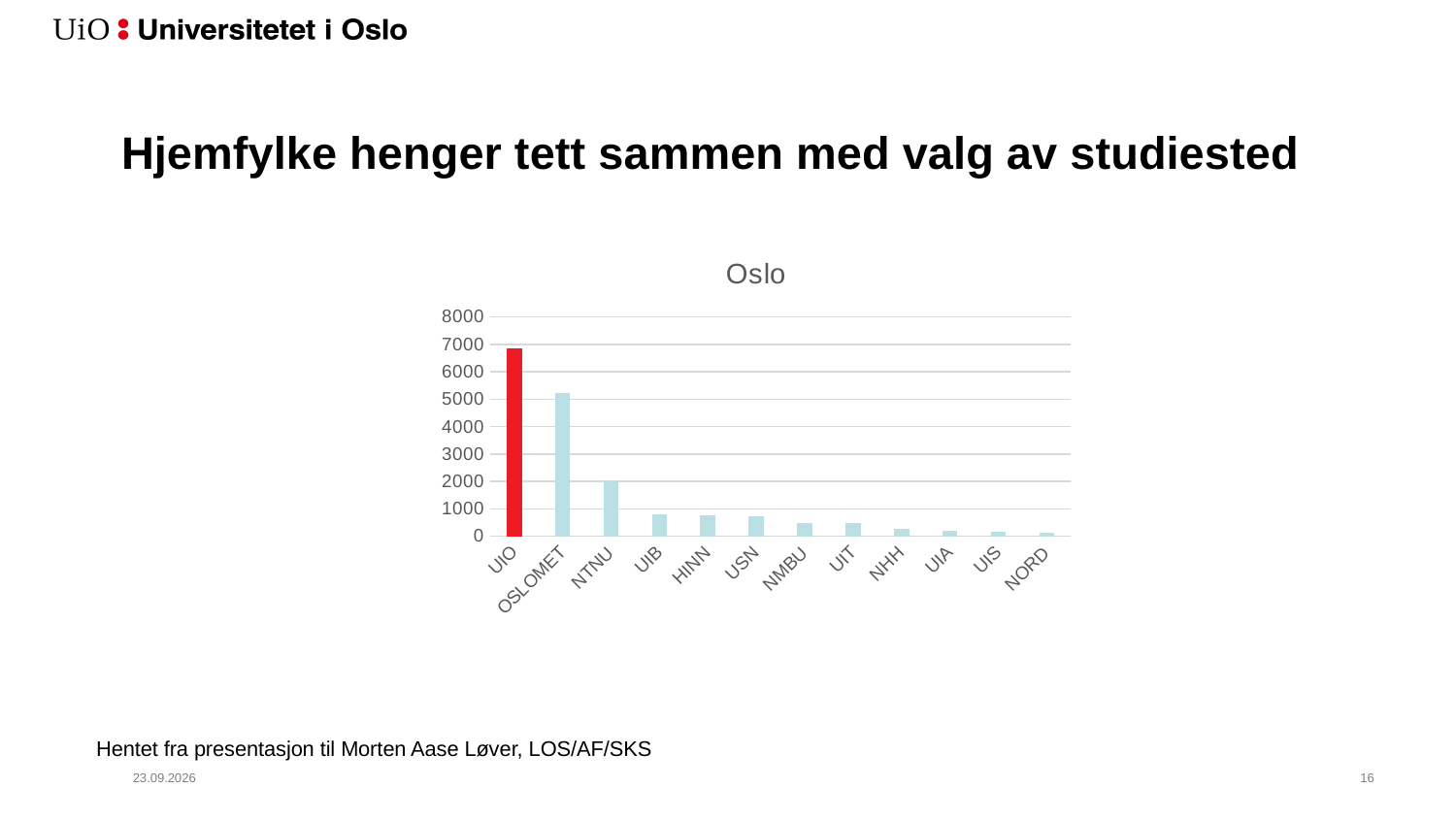
Which institution has the highest bar in the chart? UIO Is the value for UIO greater or less than 6000? greater Is the value for OSLOMET greater or less than 6000? less Is the value for NTNU greater or less than 3000? less How many institutions (categories) are shown on the x axis of the chart? 12 Do the bar values rise or fall moving from left to right along the x axis? Fall Which is larger, the value for NTNU or the value for UIB? NTNU What kind of chart is shown on the slide? Bar chart Which bar in the chart is coloured red rather than light blue? UIO What is the title of the chart? Oslo Which is larger, the value for UIO or the value for OSLOMET? UIO